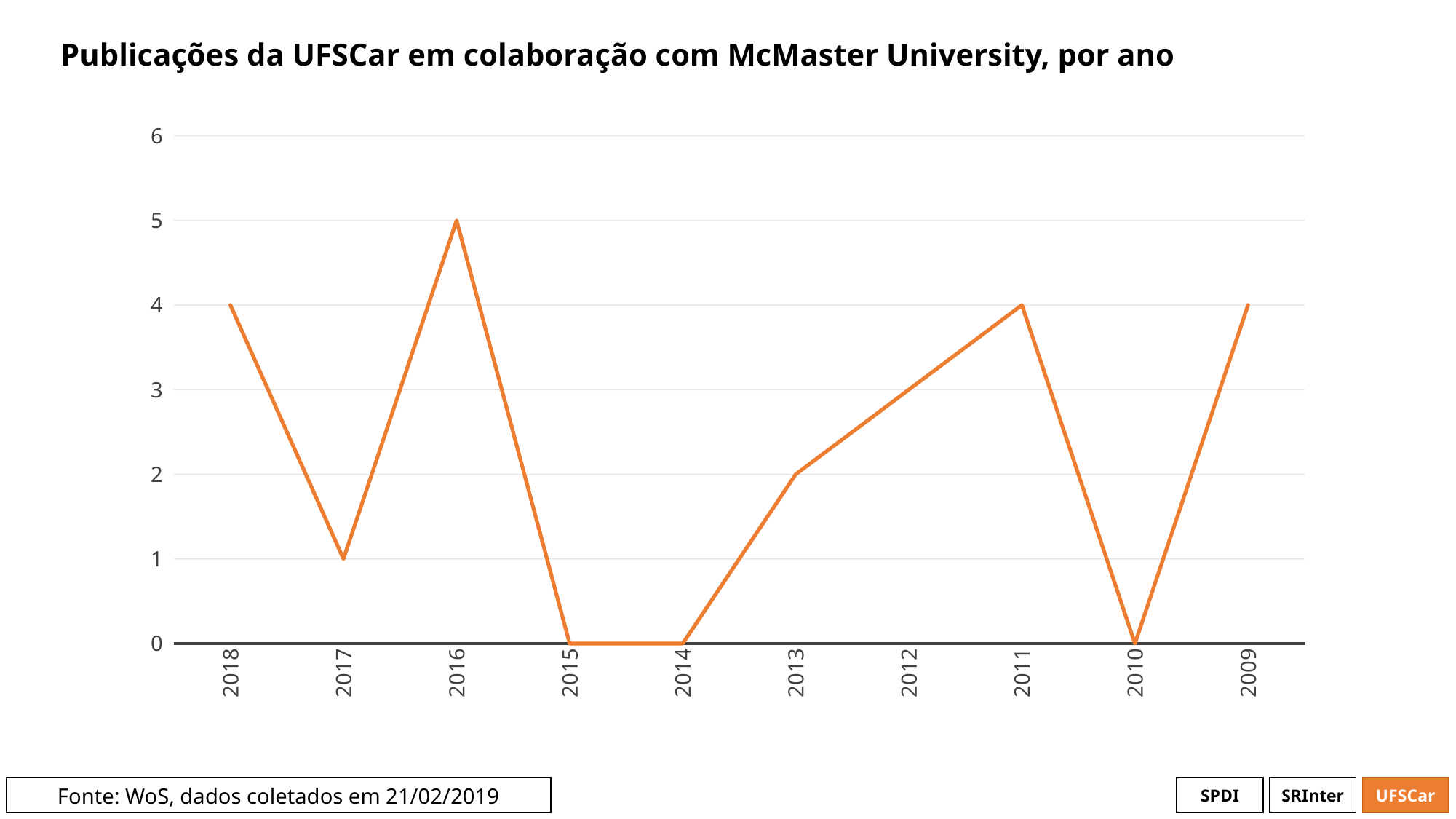
What is the title of the chart? Publicações da UFSCar em colaboração com McMaster University, por ano What is the number of publications for 2010? 0 What is the number of publications for 2018? 4 What is the number of publications for 2013? 2 Which year has the highest number of publications? 2016 What is the number of publications for 2017? 1 How many years are plotted on the x axis? 10 Does the value rise or fall from 2018 to 2017? fall Which year has the larger value, 2011 or 2013? 2011 What kind of chart is shown on the slide? line chart What is the difference between the values for 2016 and 2017? 4 What is the number of publications for 2016? 5